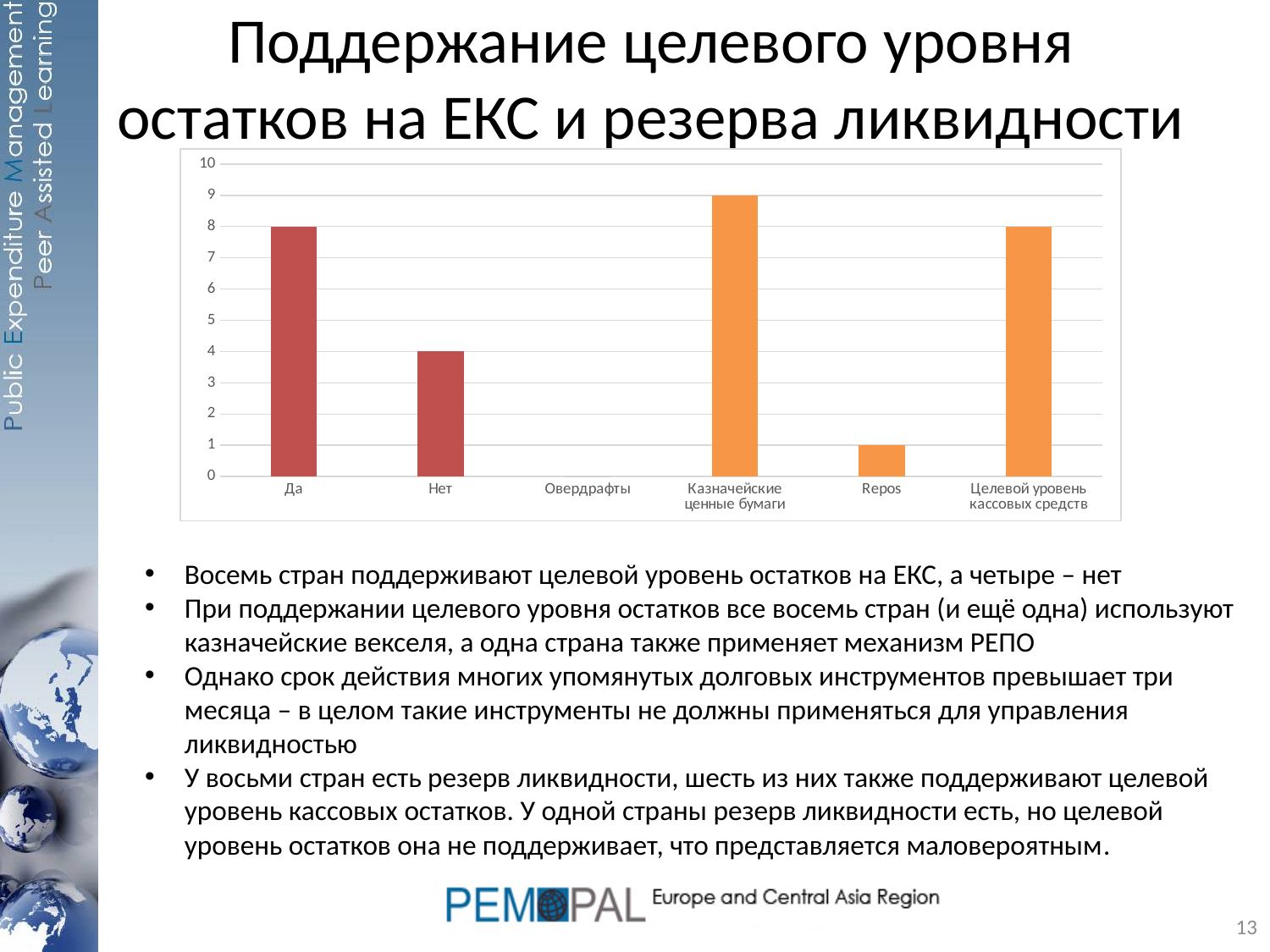
What is the value for "Нет" in the chart? 4 What is the value for "Да" in the chart? 8 What is the maximum value shown on the vertical axis of the chart? 10 How many categories are shown on the x axis of the chart? 6 What is the value for "Repos" in the chart? 1 What type of chart is shown on the slide? bar chart What is the difference between the values for "Да" and "Нет"? 4 Which is larger, the value for "Нет" or the value for "Repos"? Нет What is the value for "Целевой уровень кассовых средств" in the chart? 8 Which category has the highest value in the chart? Казначейские ценные бумаги What is the value for "Казначейские ценные бумаги" in the chart? 9 Which category has the lowest value in the chart? Овердрафты